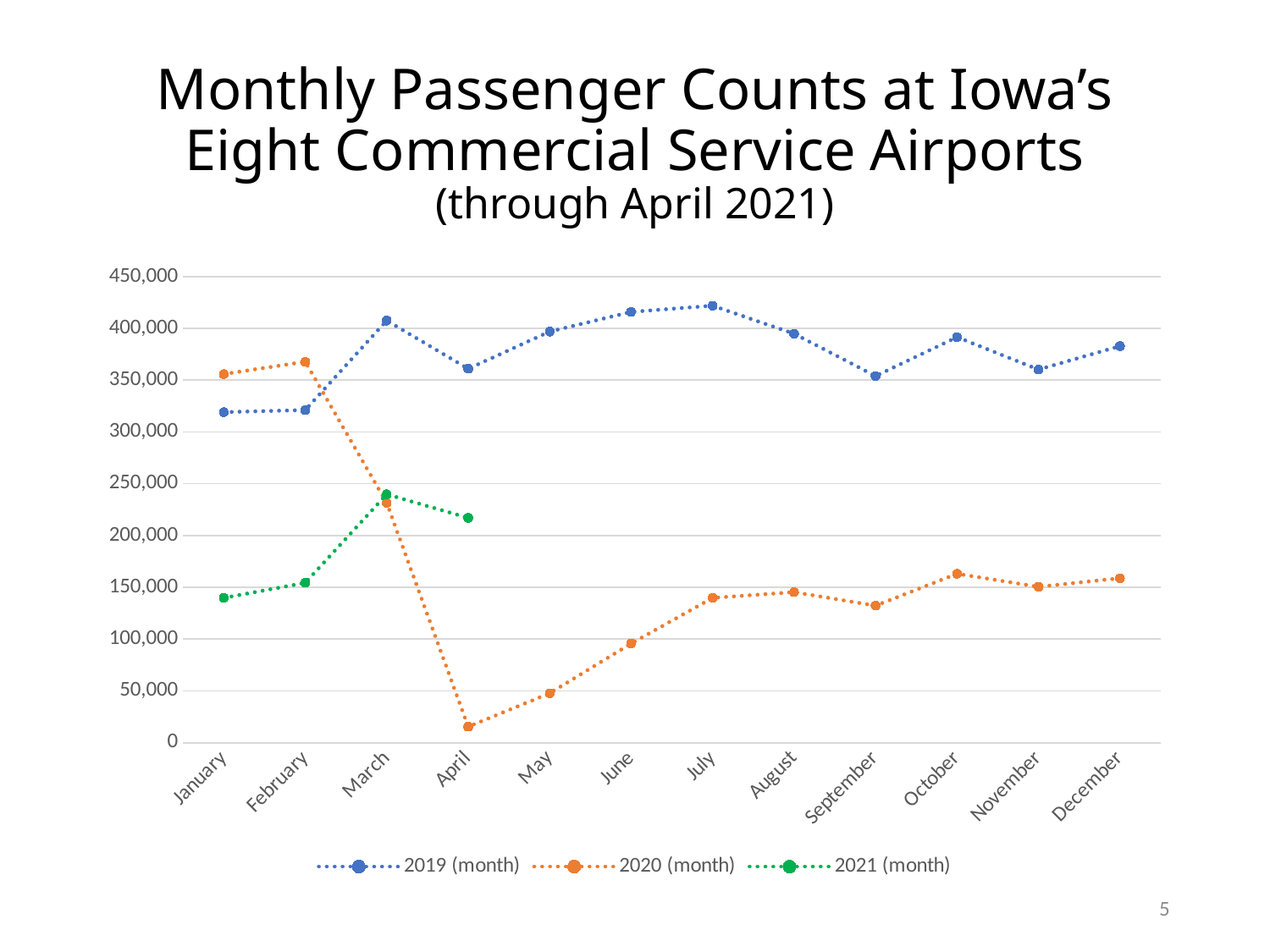
How many months are shown along the x axis? 12 How many data points are plotted for the 2021 (month) series? 4 In which month is the 2020 (month) value lowest? April How many series does the legend list? 3 Which series is drawn in green? 2021 (month) What kind of chart is shown on the slide? line chart Is the 2019 (month) value for March greater or less than 400,000? greater In which month is the 2021 (month) value highest? March Is the 2020 (month) value for April greater or less than 50,000? less In which month is the 2019 (month) value highest? July Does the 2020 (month) series rise or fall from February to April? fall Which is larger in April: the 2020 (month) value or the 2021 (month) value? 2021 (month)